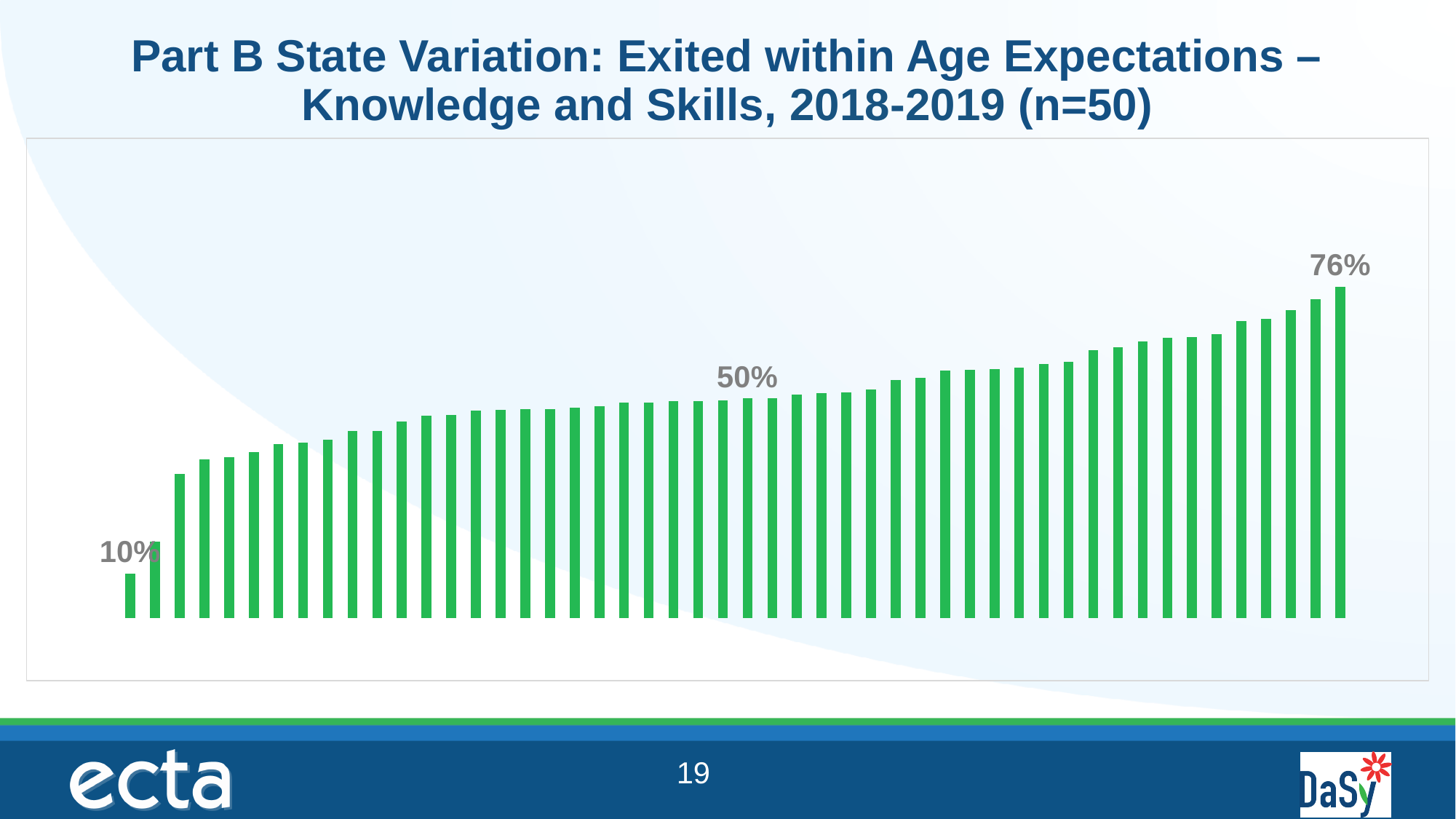
What kind of chart is shown on the slide? bar chart What is the title of the slide containing the chart? Part B State Variation: Exited within Age Expectations – Knowledge and Skills, 2018-2019 (n=50) Which is larger, the value of the leftmost bar or the value of the rightmost bar? the rightmost bar Which is larger, the value labelled on the middle bar or the value labelled on the first bar? the middle bar (50%) What is the value of the highest bar in the chart? 76% What is the difference between the highest labelled value (76%) and the lowest labelled value (10%)? 66 percentage points What colour are the bars in the chart? green Do the bar values rise or fall from left to right across the chart? rise What is the value of the lowest bar in the chart? 10% What is the difference between the middle bar's labelled value (50%) and the lowest bar's value (10%)? 40 percentage points How many states (bars) are represented in the chart? 50 What value is labelled on the middle bar of the chart? 50%